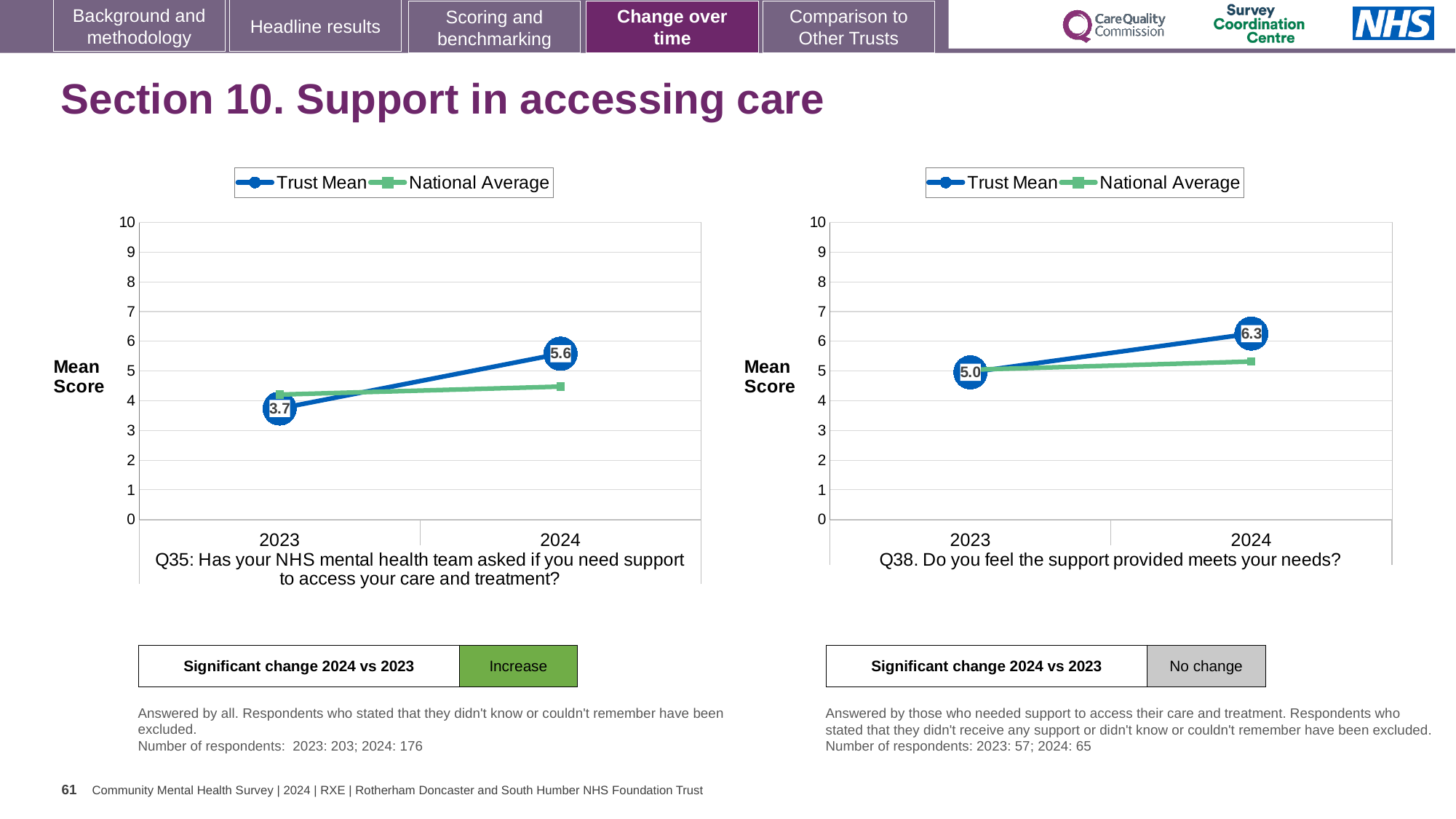
In the Q35 chart on the left, what is the Trust Mean score for 2024? 5.6 In the Q35 chart on the left, does the Trust Mean rise or fall from 2023 to 2024? rise In the Q38 chart on the right, by how much did the Trust Mean score change from 2023 to 2024? 1.3 How many series does the legend of the Q38 chart on the right list? 2 In the Q35 chart on the left, is the National Average value for 2024 greater or less than 5? less In the Q35 chart on the left, which is larger in 2024, the Trust Mean or the National Average? Trust Mean In the Q35 chart on the left, what is the Trust Mean score for 2023? 3.7 In the Q38 chart on the right, what is the Trust Mean score for 2023? 5.0 What kind of chart is the Q38 chart on the right? line chart How many years are plotted on the x axis of the Q35 chart on the left? 2 In the Q35 chart on the left, by how much did the Trust Mean score change from 2023 to 2024? 1.9 In the Q38 chart on the right, what is the Trust Mean score for 2024? 6.3